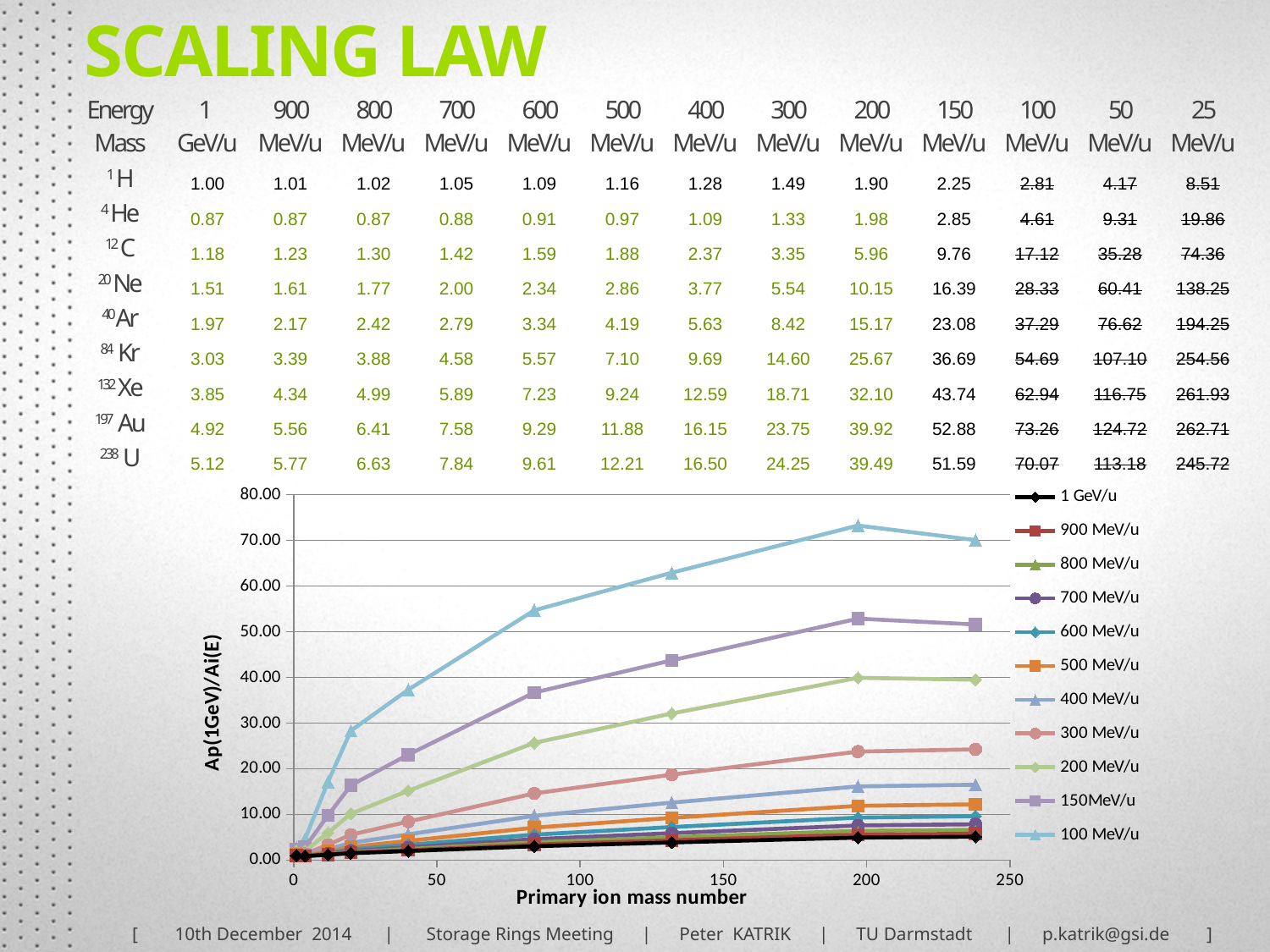
Is the value of the 100 MeV/u series at mass number 197 greater or less than 70? greater What kind of chart is shown on the slide? line chart How many series does the chart legend list? 11 What is the title of the chart's y axis? Ap(1GeV)/Ai(E) Does the 300 MeV/u series generally rise or fall as the primary ion mass number increases? rise Which series stays lowest across the chart? 1 GeV/u What is the title of the chart's x axis? Primary ion mass number Is the value of the 300 MeV/u series at mass number 238 greater or less than 20? greater Is the value of the 100 MeV/u series at mass number 40 greater or less than 40? less At mass number 197, which series is higher: 100 MeV/u or 150 MeV/u? 100 MeV/u Which series reaches the highest value on the chart? 100 MeV/u